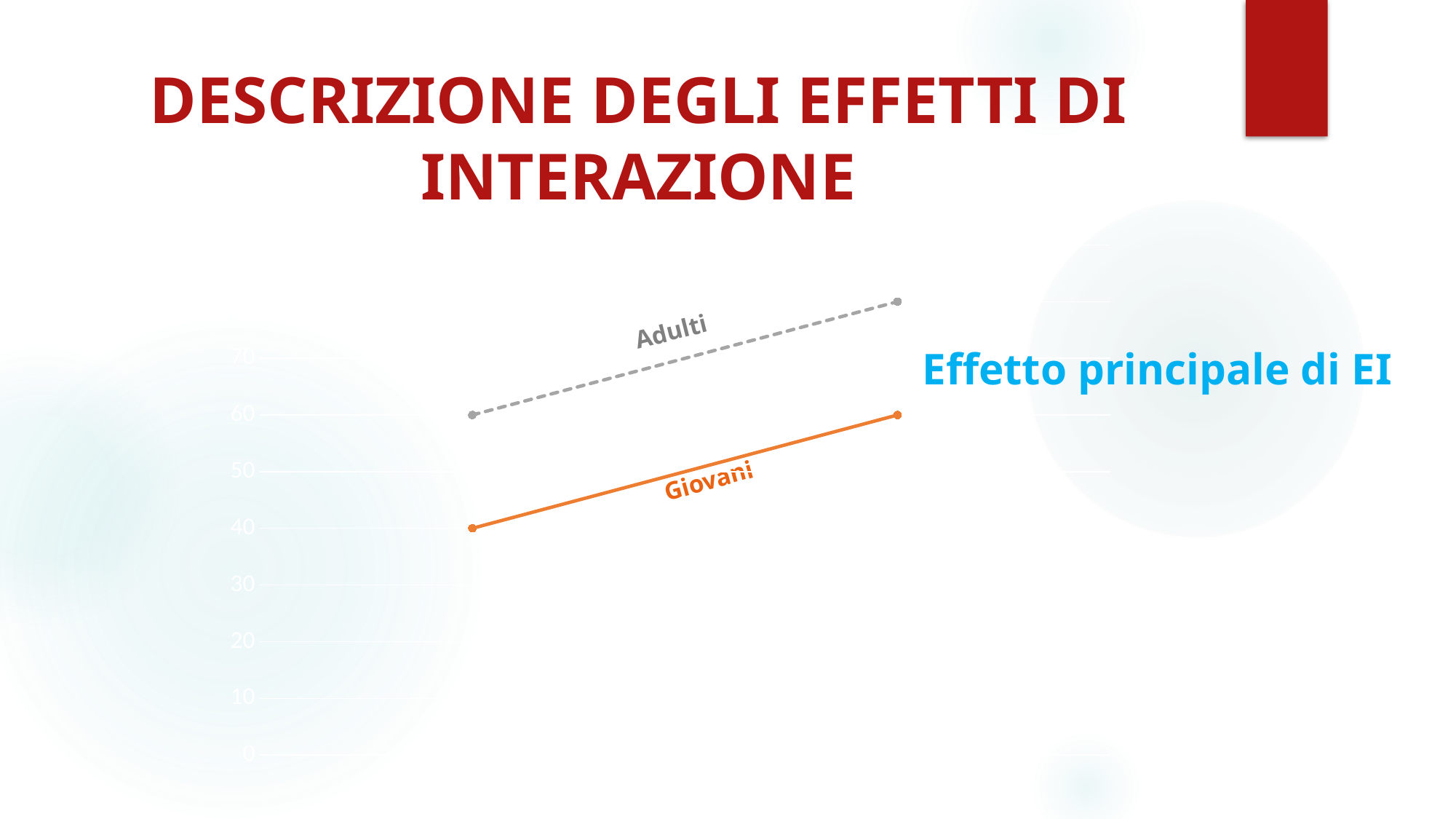
What is the value of the Adulti series at its left end? 60 Does the Adulti line rise or fall from left to right? rise What is the value of the Giovani series at its right end? 60 What is the value of the Giovani series at its left end? 40 What colour is the Giovani line? orange Does the Giovani line rise or fall from left to right? rise What kind of chart is shown on the slide? line chart Which series has the higher values, Adulti or Giovani? Adulti How many series are plotted on the chart? 2 What is the difference between the Adulti and Giovani values at the left end of the chart? 20 Is the value of the Adulti series at its right end greater or less than 70? greater What are the names of the two series plotted on the chart? Adulti and Giovani